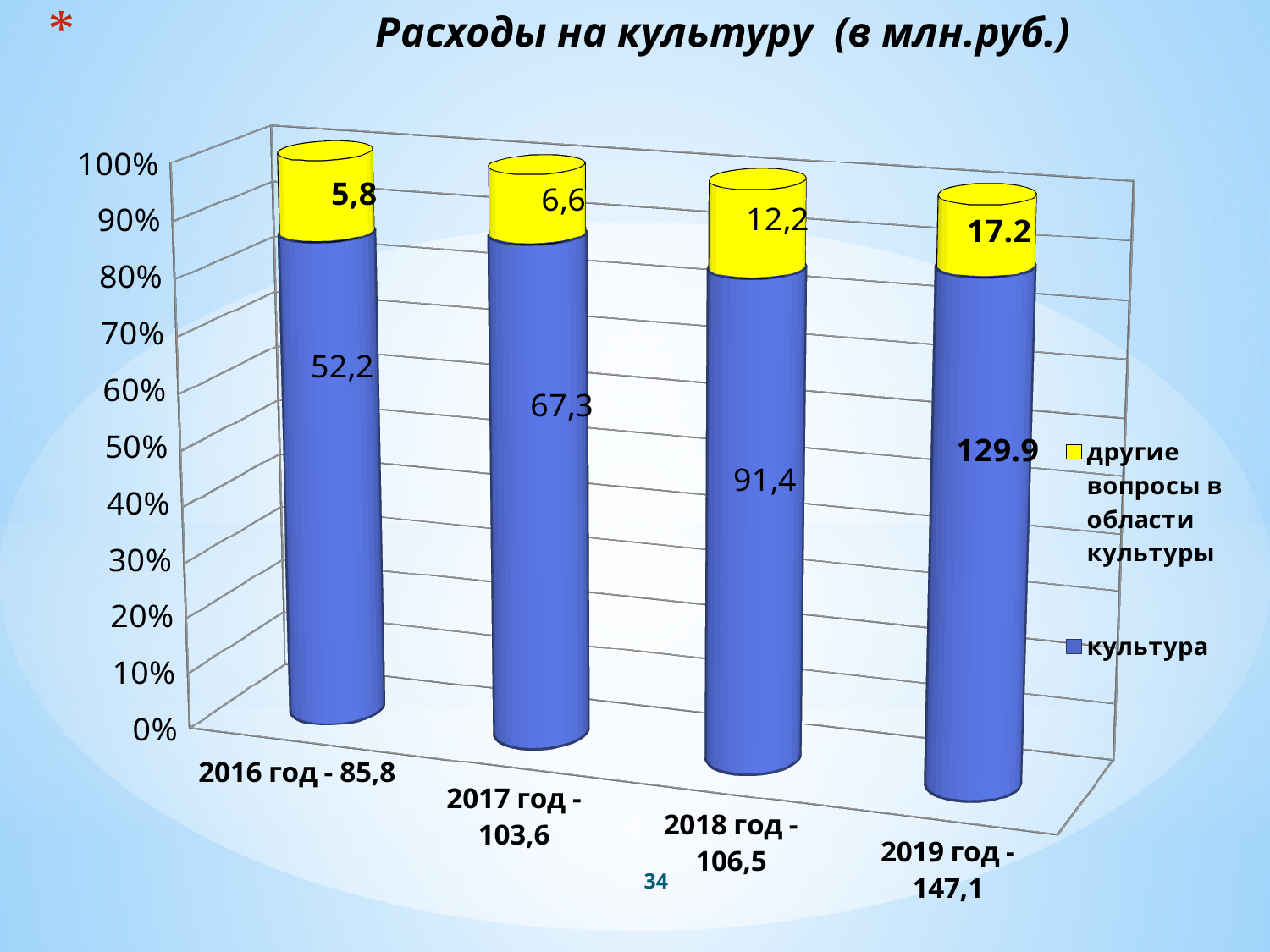
What is the difference between the культура values for 2018 and 2017? 24,1 In which year is the value for другие вопросы в области культуры the lowest? 2016 Which year has the larger value for другие вопросы в области культуры, 2018 or 2017? 2018 How many series does the legend list? 2 Do the values for культура rise or fall from 2016 to 2019? Rise What is the value for другие вопросы в области культуры in 2017? 6,6 How many years are shown on the x axis? 4 In which year is the value for культура the highest? 2019 What is the value for другие вопросы в области культуры in 2016? 5,8 What is the value for культура in 2019? 129.9 What kind of chart is shown on the slide? Stacked bar chart What is the value for культура in 2018? 91,4